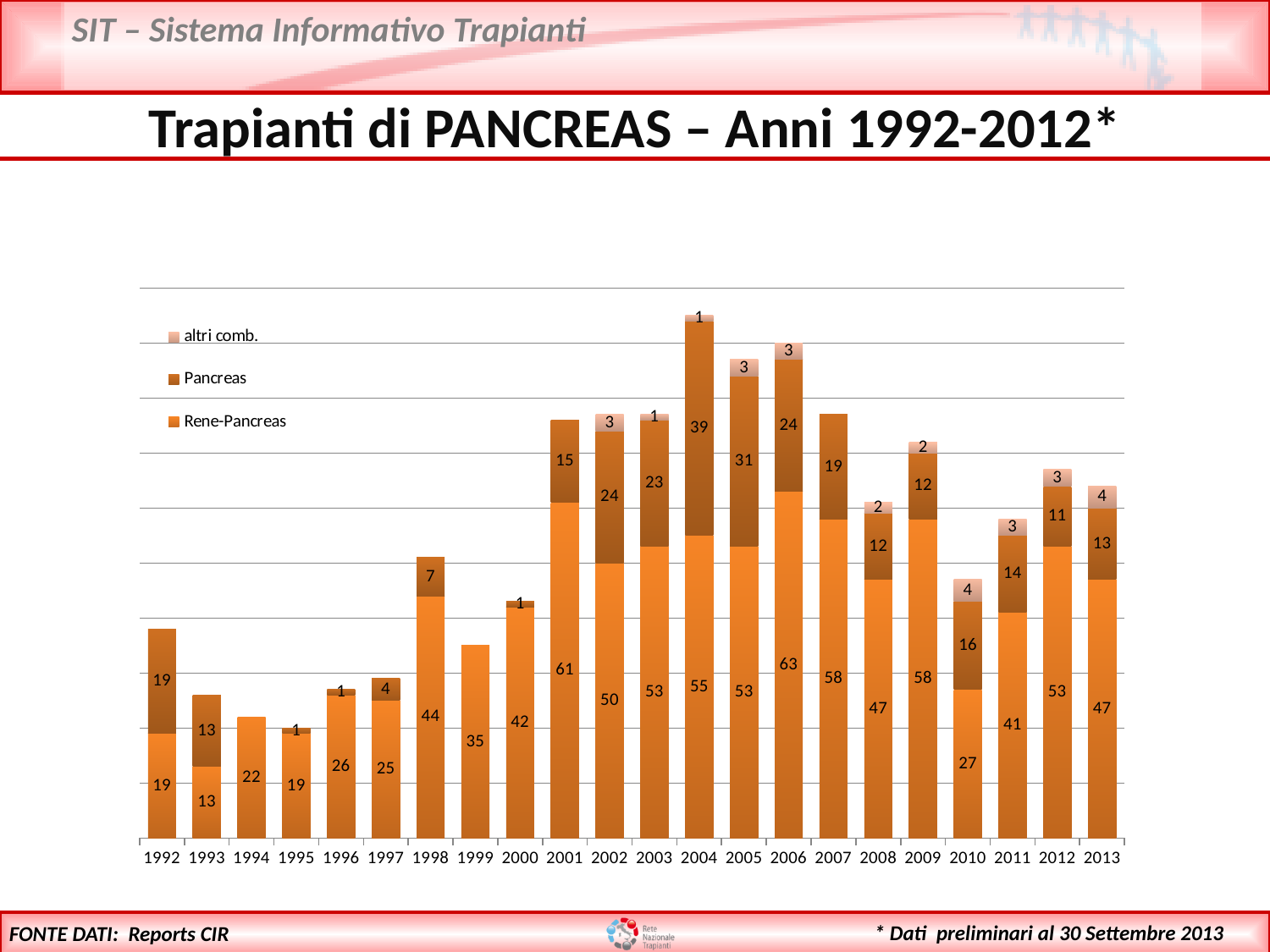
What is the total of the stacked bar for 2006? 90 How many years are shown on the x axis? 22 In which year is the Rene-Pancreas value lowest? 1993 What is the total of the stacked bar for 2013? 64 What is the Pancreas value for 2004? 39 In which year is the Pancreas value highest? 2004 What kind of chart is shown on the slide? Stacked bar chart Which year has the larger Pancreas value, 2005 or 2007? 2005 How many series does the legend list? 3 What is the altri comb. value for 2013? 4 What is the difference between the Rene-Pancreas values for 2006 and 2010? 36 What is the Rene-Pancreas value for 2001? 61